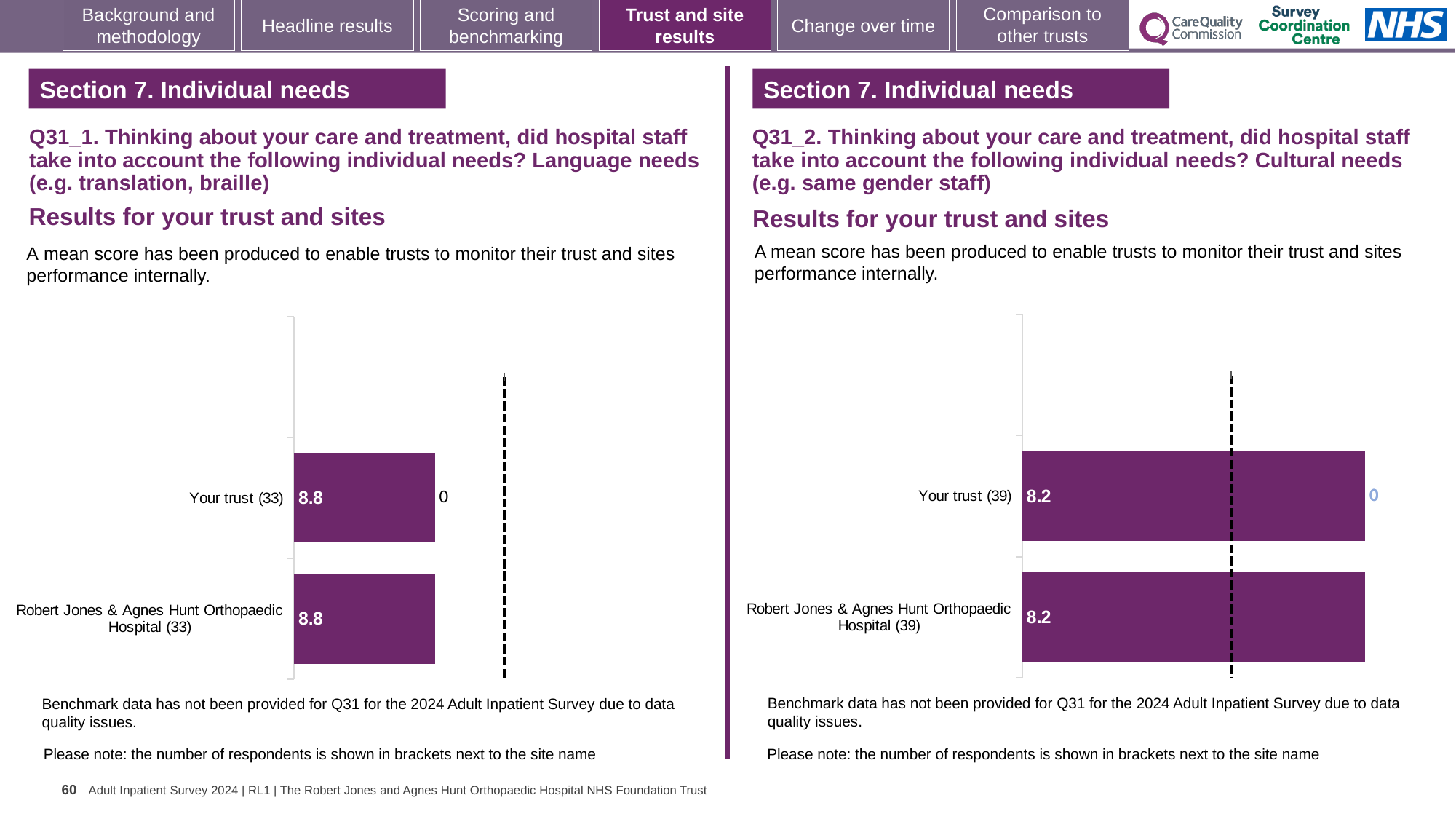
Is the Your trust score higher in the left chart (Q31_1, Language needs) or in the right chart (Q31_2, Cultural needs)? Left chart (Q31_1, Language needs) What type of chart is used in the right chart (Q31_2, Cultural needs)? Bar chart In the left chart (Q31_1, Language needs), how many respondents are shown in brackets next to Your trust? 33 In the left chart (Q31_1, Language needs), what is the difference between the score for Your trust and the score for Robert Jones & Agnes Hunt Orthopaedic Hospital? 0 In the right chart (Q31_2, Cultural needs), what is the mean score for Robert Jones & Agnes Hunt Orthopaedic Hospital? 8.2 How many bars are plotted in the left chart (Q31_1, Language needs)? 2 In the right chart (Q31_2, Cultural needs), how many respondents are shown in brackets next to Robert Jones & Agnes Hunt Orthopaedic Hospital? 39 In the right chart (Q31_2, Cultural needs), what is the mean score for Your trust? 8.2 In the left chart (Q31_1, Language needs), what is the mean score for Robert Jones & Agnes Hunt Orthopaedic Hospital? 8.8 How many bars are plotted in the right chart (Q31_2, Cultural needs)? 2 In the left chart (Q31_1, Language needs), what is the mean score for Your trust? 8.8 In the right chart (Q31_2, Cultural needs), what is the difference between the score for Your trust and the score for Robert Jones & Agnes Hunt Orthopaedic Hospital? 0